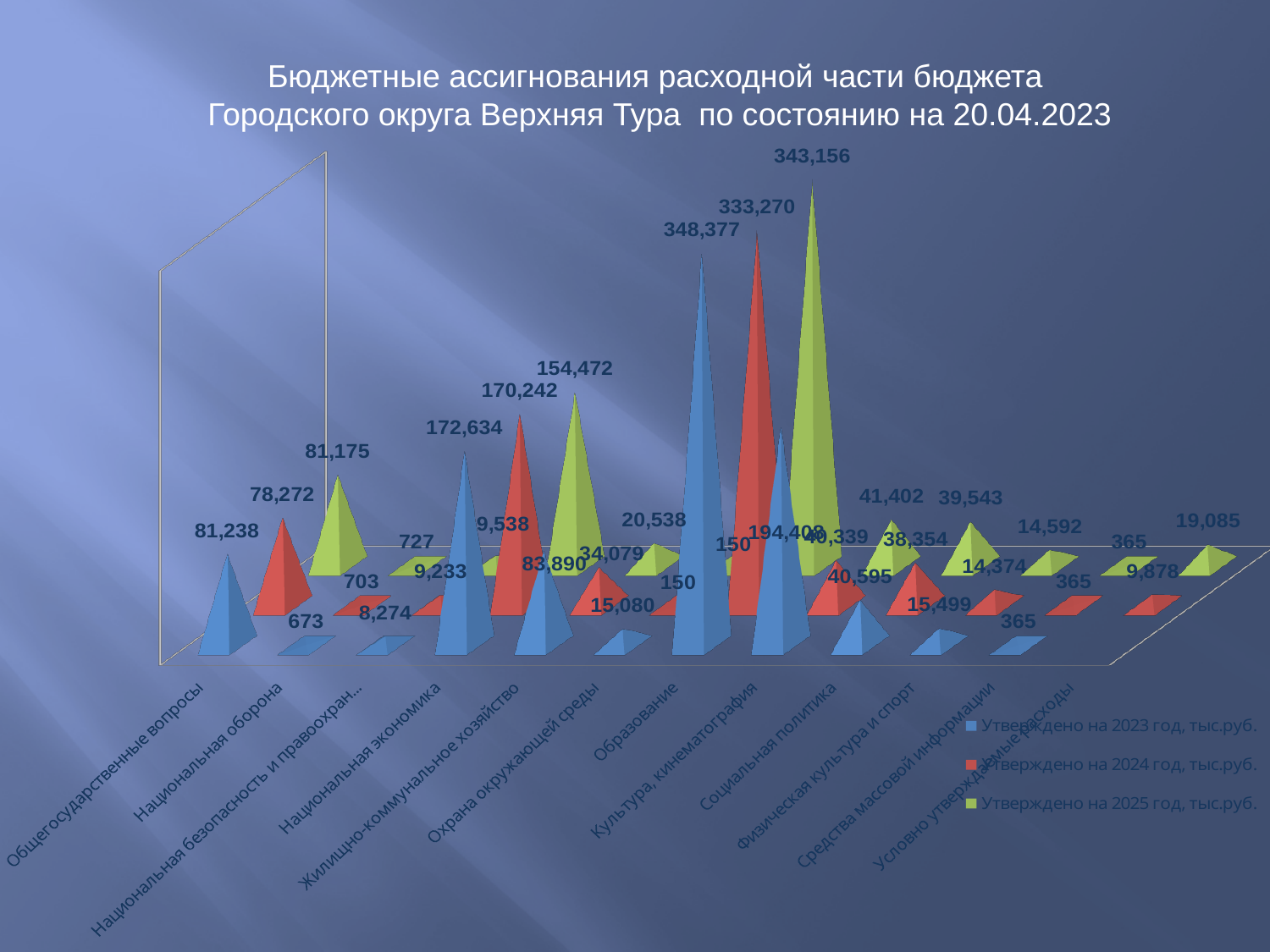
What is the value for Образование in the series 'Утверждено на 2023 год, тыс.руб.'? 348,377 What is the difference between the 2023 and 2024 values for Образование? 15,107 What is the value for Национальная экономика in the series 'Утверждено на 2025 год, тыс.руб.'? 154,472 How many expenditure categories are shown along the x axis? 12 What is the value for Жилищно-коммунальное хозяйство in the series 'Утверждено на 2023 год, тыс.руб.'? 83,890 Which is larger for Образование: the value approved for 2023 or the value approved for 2025? 2023 Which category has the highest value in the series 'Утверждено на 2025 год, тыс.руб.'? Образование What is the difference between the 2023 and 2025 values for Национальная экономика? 18,162 What kind of chart is shown on the slide? bar chart What is the value for Национальная оборона in the series 'Утверждено на 2024 год, тыс.руб.'? 703 Which category has the lowest value in the series 'Утверждено на 2024 год, тыс.руб.'? Охрана окружающей среды How many series does the legend list? 3